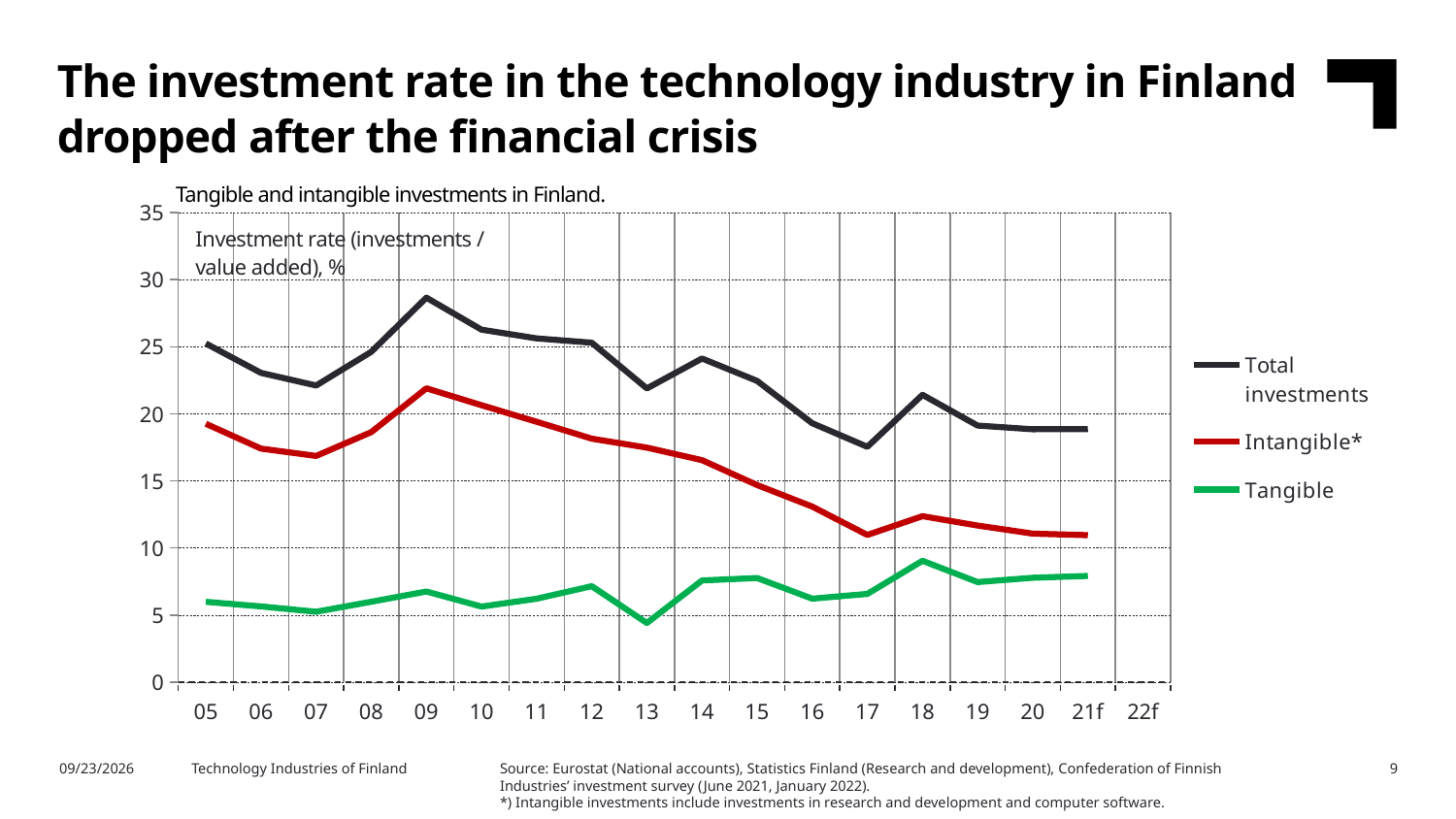
In which year does the Total investments line reach its highest value? 09 In which year does the Tangible line reach its highest value? 18 In which year does the Total investments line reach its lowest value? 17 Is the value for Total investments in 09 greater or less than 25? greater What is the title of the chart? Tangible and intangible investments in Finland. How many series does the legend list? 3 Does the Intangible* line rise or fall between 09 and 17? fall In which year does the Tangible line reach its lowest value? 13 In which year does the Intangible* line reach its highest value? 09 Which series has the larger value in 05, Intangible* or Tangible? Intangible* Is the value for Intangible* in 17 greater or less than 15? less What kind of chart is shown on the slide? line chart